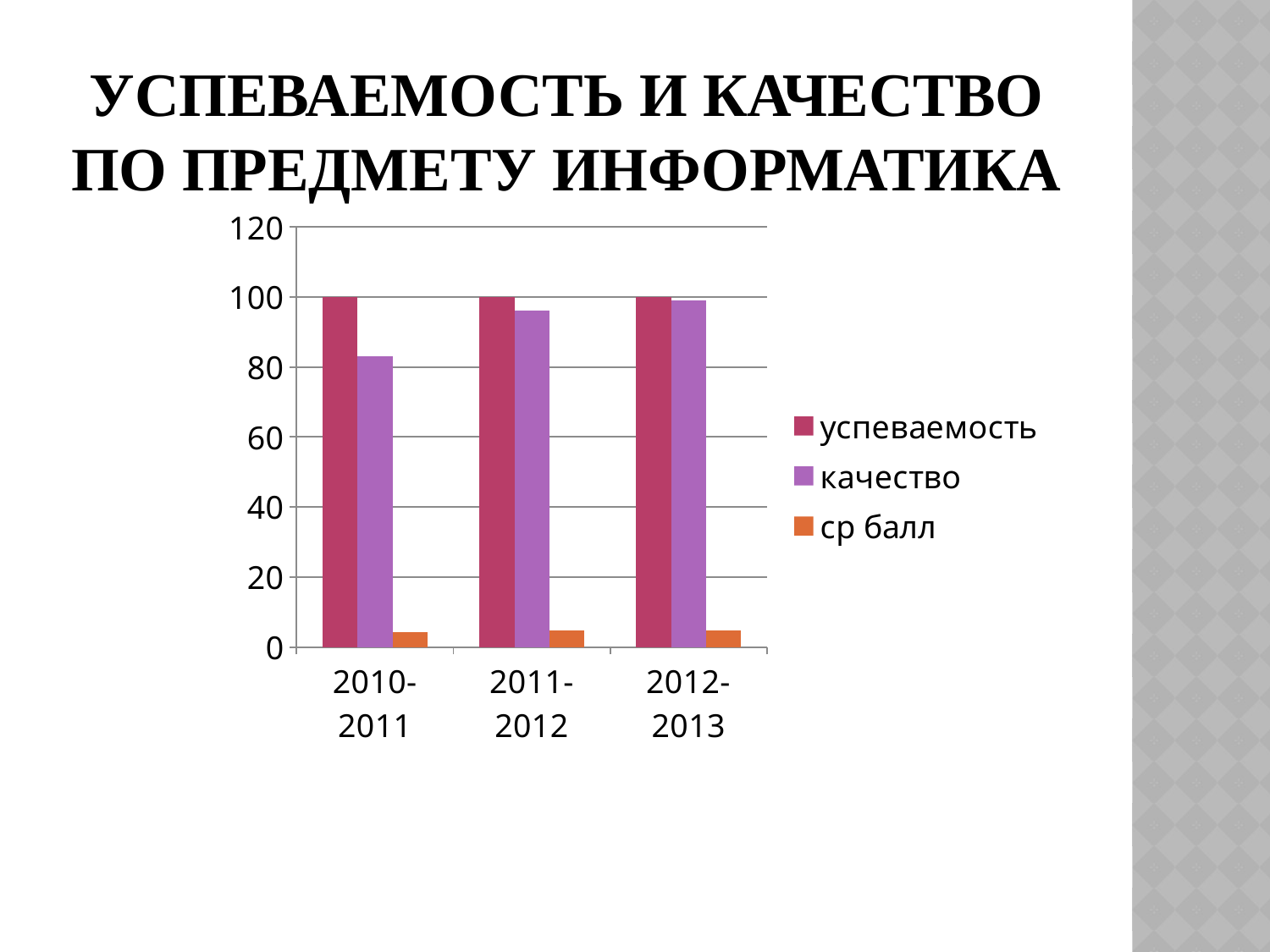
How many academic-year categories are shown on the x axis? 3 Is the value of ср балл for 2011-2012 greater or less than 20? less What is the value of успеваемость for 2012-2013? 100 Which series is shown in orange in the legend? ср балл Does the value of качество rise or fall from 2010-2011 to 2012-2013? rises Which academic year has the lowest value of качество? 2010-2011 Is the value of качество for 2010-2011 greater or less than 100? less What is the value of успеваемость for 2010-2011? 100 What kind of chart is shown on the slide? bar chart Which is larger: качество for 2010-2011 or качество for 2012-2013? 2012-2013 How many series does the legend list? 3 Which series is listed first in the legend? успеваемость